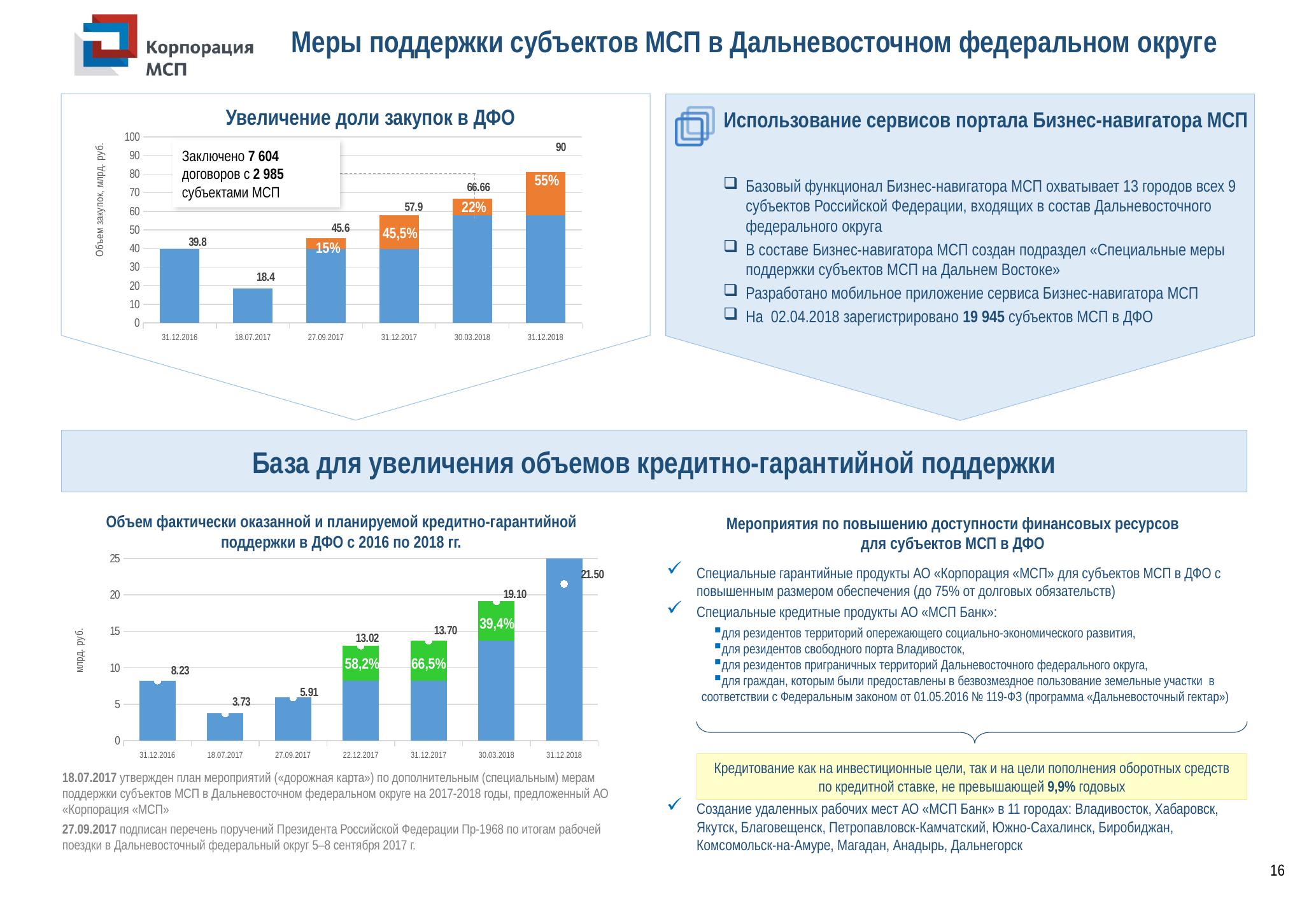
In the bottom-left chart on credit and guarantee support in ДФО, what is the value for 22.12.2017? 13.02 How many dates are shown on the x axis of the bottom-left chart on credit and guarantee support in ДФО? 7 What kind of chart is 'Увеличение доли закупок в ДФО'? Bar chart In the bottom-left chart on credit and guarantee support in ДФО, which is larger: the value for 31.12.2016 or for 27.09.2017? 31.12.2016 In the chart 'Увеличение доли закупок в ДФО', what is the value for 31.12.2016? 39.8 In the chart 'Увеличение доли закупок в ДФО', what is the value for 30.03.2018? 66.66 In the bottom-left chart on credit and guarantee support in ДФО, what is the difference between the values for 30.03.2018 and 31.12.2017? 5.40 How many dates are shown on the x axis of the chart 'Увеличение доли закупок в ДФО'? 6 In the chart 'Увеличение доли закупок в ДФО', what is the difference between the values for 31.12.2017 and 27.09.2017? 12.3 In the bottom-left chart on credit and guarantee support in ДФО, which date has the lowest value? 18.07.2017 In the chart 'Увеличение доли закупок в ДФО', which date has the lowest value? 18.07.2017 In the bottom-left chart on credit and guarantee support in ДФО, which date has the highest value? 31.12.2018